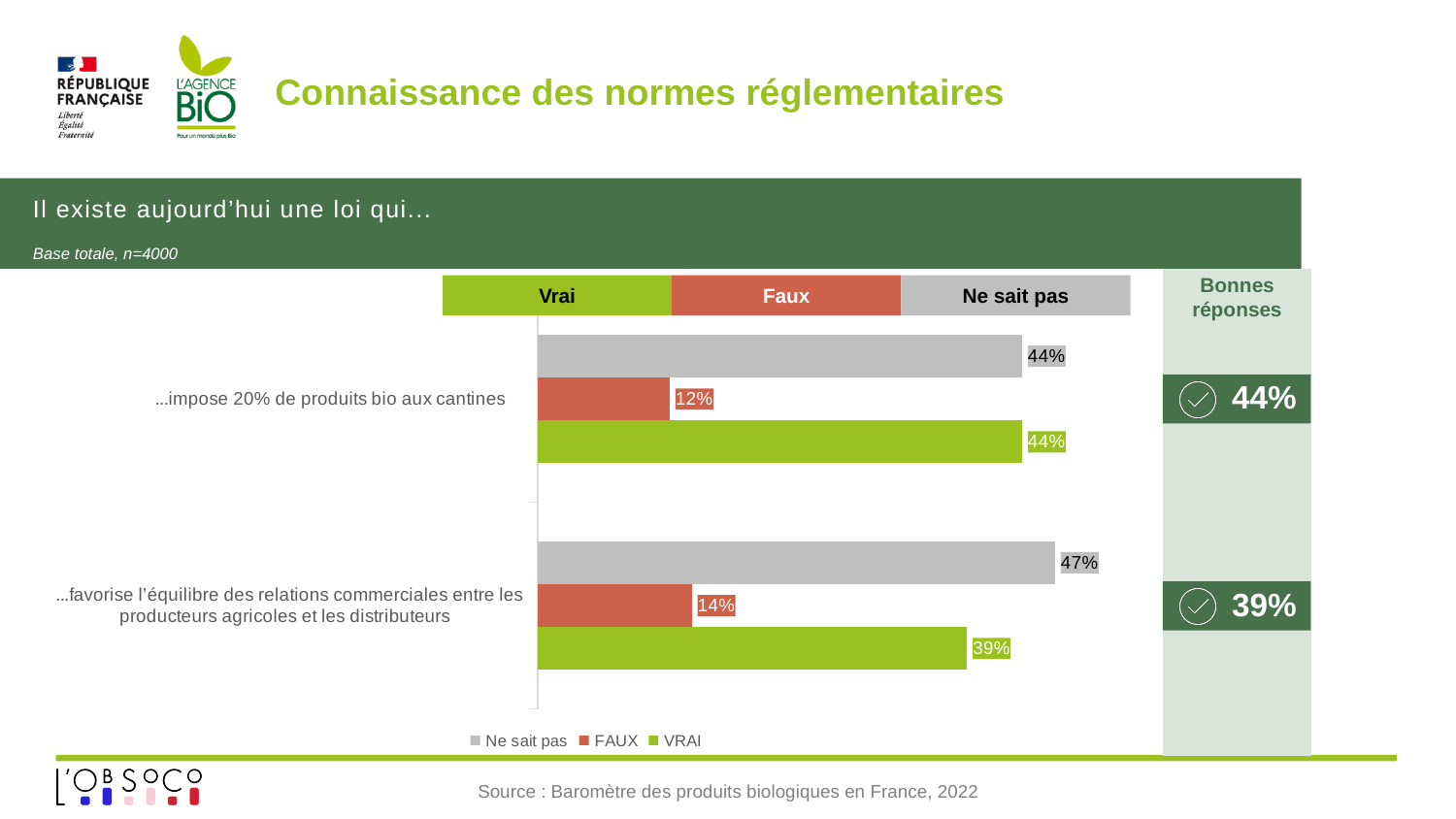
What percentage of respondents answered VRAI for "...impose 20% de produits bio aux cantines"? 44% What type of chart is shown on the slide? Bar chart What is the difference between the "Ne sait pas" values of the two statements? 3% What percentage of respondents answered FAUX for "...favorise l'équilibre des relations commerciales entre les producteurs agricoles et les distributeurs"? 14% Is the VRAI value larger for "...impose 20% de produits bio aux cantines" or for "...favorise l'équilibre des relations commerciales entre les producteurs agricoles et les distributeurs"? ...impose 20% de produits bio aux cantines What is the "Ne sait pas" value for "...favorise l'équilibre des relations commerciales entre les producteurs agricoles et les distributeurs"? 47% For "...favorise l'équilibre des relations commerciales entre les producteurs agricoles et les distributeurs", what is the difference between the "Ne sait pas" and VRAI values? 8% How many statements (categories) are shown in the chart? 2 Which statement has the higher VRAI percentage? ...impose 20% de produits bio aux cantines How many series does the chart legend list? 3 What is the FAUX value for "...impose 20% de produits bio aux cantines"? 12% Which series has the lowest value for "...favorise l'équilibre des relations commerciales entre les producteurs agricoles et les distributeurs"? FAUX